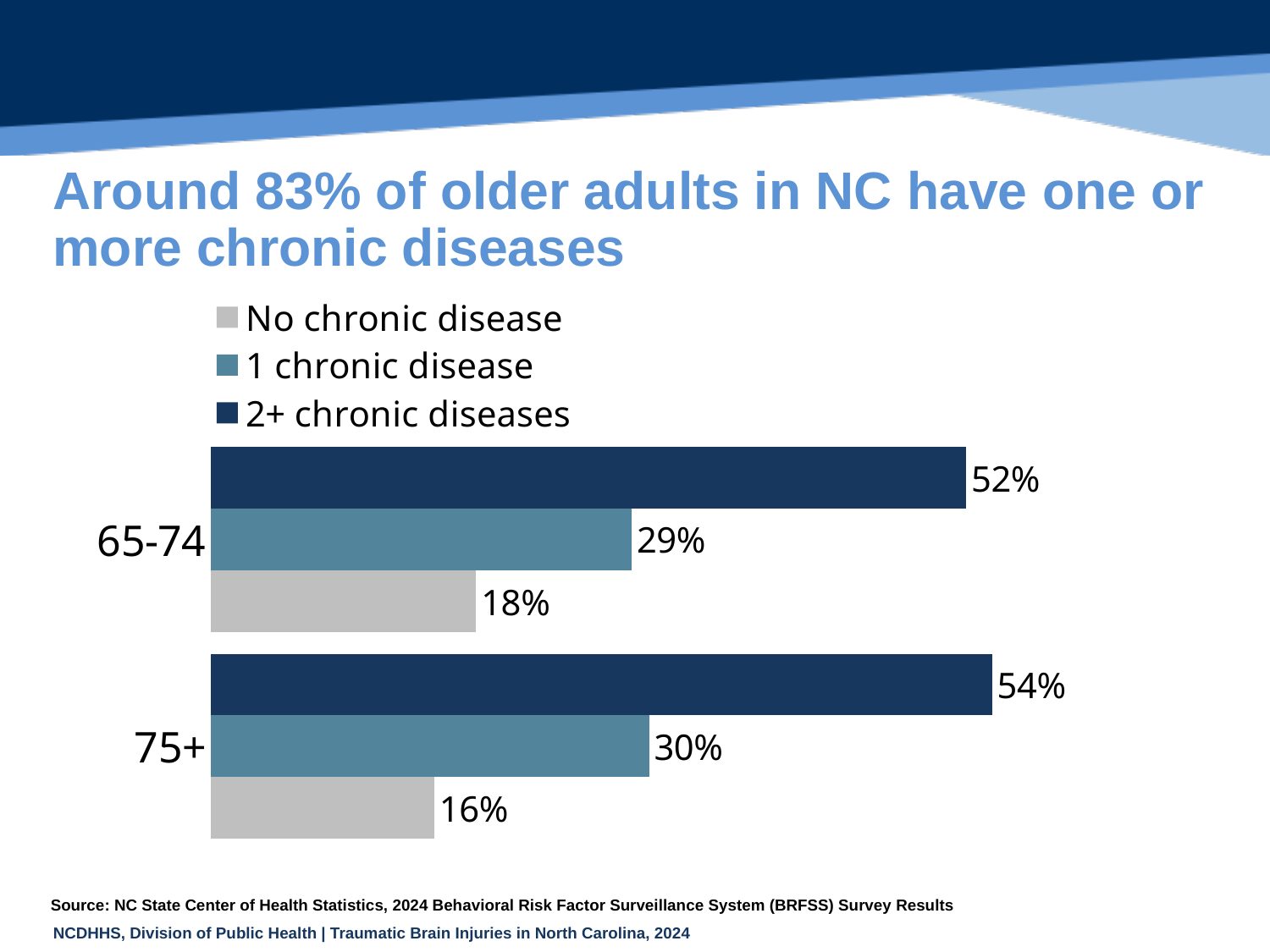
How many age groups are shown on the chart? 2 How many series does the legend list? 3 What percentage of adults aged 65-74 have no chronic disease? 18% What type of chart is shown on the slide? Bar chart Which legend entry is shown in the darkest blue colour? 2+ chronic diseases Which age group has the lower percentage with no chronic disease? 75+ What is the difference in percentage points between the 2+ chronic diseases value for 75+ and for 65-74? 2 What percentage of adults aged 75+ have 1 chronic disease? 30% Which age group has the higher percentage with 2+ chronic diseases? 75+ What is the difference in percentage points between the no chronic disease value for 65-74 and for 75+? 2 What percentage of adults aged 65-74 have 2+ chronic diseases? 52% What percentage of adults aged 75+ have no chronic disease? 16%